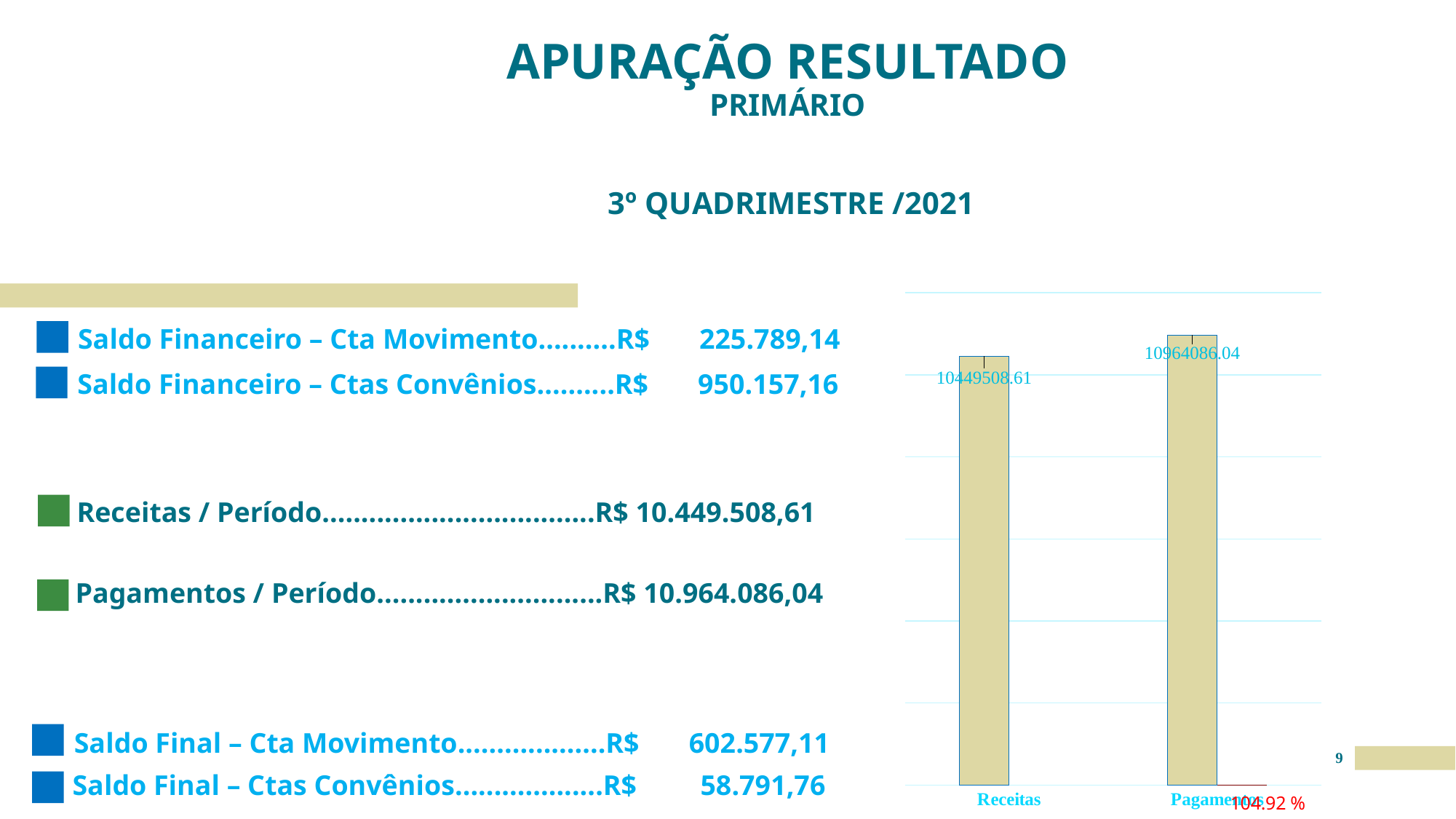
What percentage is printed in red at the bottom right of the chart? 104.92 % Which category has the highest bar in the chart? Pagamentos What is the value of the Pagamentos bar in the chart? 10964086.04 What is the difference between the Pagamentos and Receitas values in the chart? 514577.43 What is the value of the Receitas bar in the chart? 10449508.61 What colour are the bars in the chart? Beige Do the bar values rise or fall from Receitas to Pagamentos? Rise How many bars are plotted in the chart? 2 Which is larger in the chart, Receitas or Pagamentos? Pagamentos What type of chart is shown on the slide? Bar chart Which category has the lowest bar in the chart? Receitas